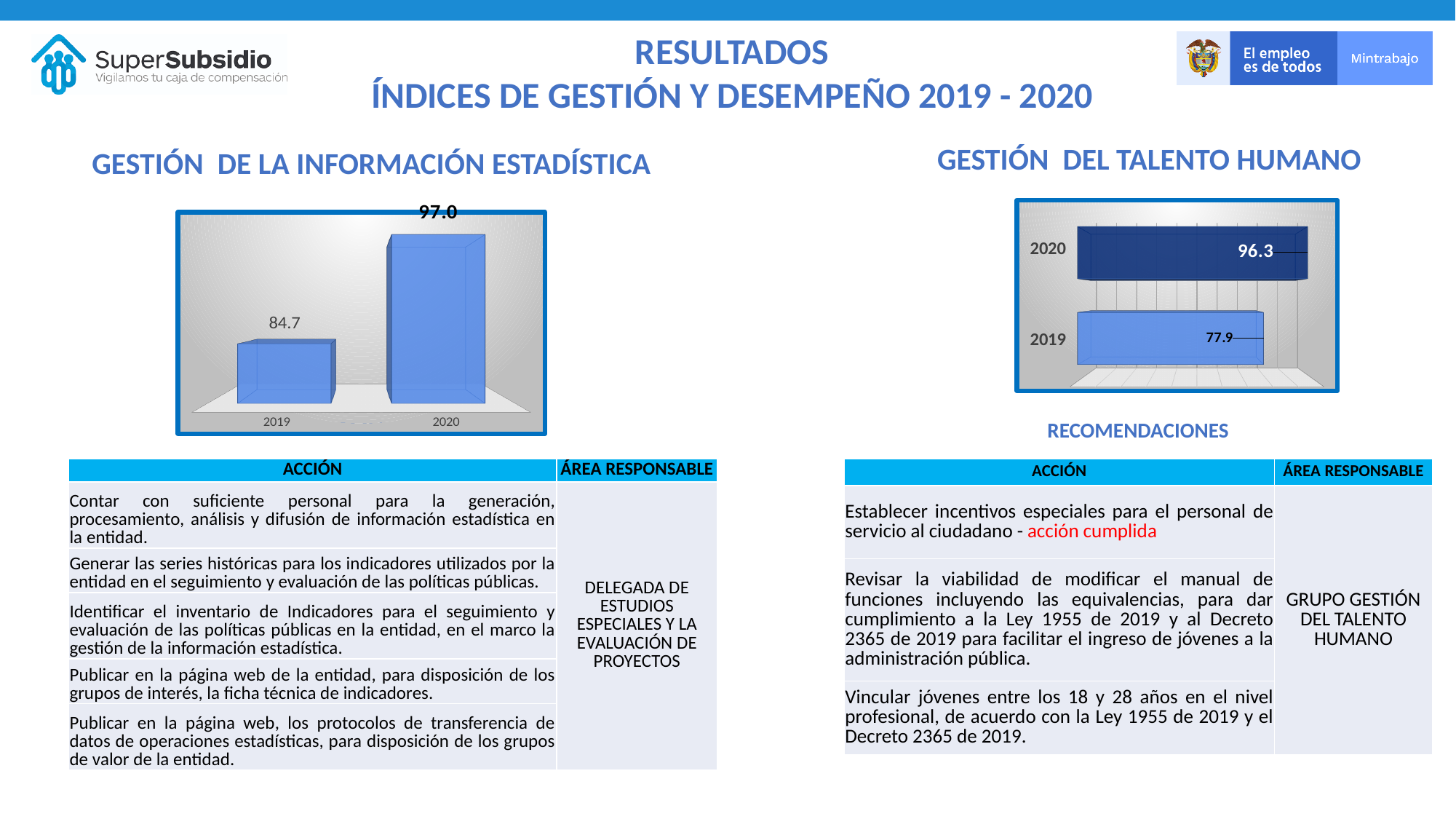
In the 'Gestión del Talento Humano' chart, what is the difference between the 2020 and 2019 values? 18.4 In the 'Gestión de la Información Estadística' chart, what is the difference between the 2020 and 2019 values? 12.3 In the 'Gestión de la Información Estadística' chart, what is the value for 2019? 84.7 In the 'Gestión del Talento Humano' chart, do the values rise or fall from 2019 to 2020? Rise In the 'Gestión de la Información Estadística' chart, which year has the higher value? 2020 Is the 2019 value in the 'Gestión del Talento Humano' chart larger or smaller than the 2019 value in the 'Gestión de la Información Estadística' chart? Smaller In the 'Gestión del Talento Humano' chart, what is the value for 2019? 77.9 In the 'Gestión de la Información Estadística' chart, how many bars are plotted? 2 What kind of chart is the 'Gestión de la Información Estadística' chart? Bar chart In the 'Gestión del Talento Humano' chart, which year has the lower value? 2019 In the 'Gestión del Talento Humano' chart, what is the value for 2020? 96.3 In the 'Gestión de la Información Estadística' chart, what is the value for 2020? 97.0